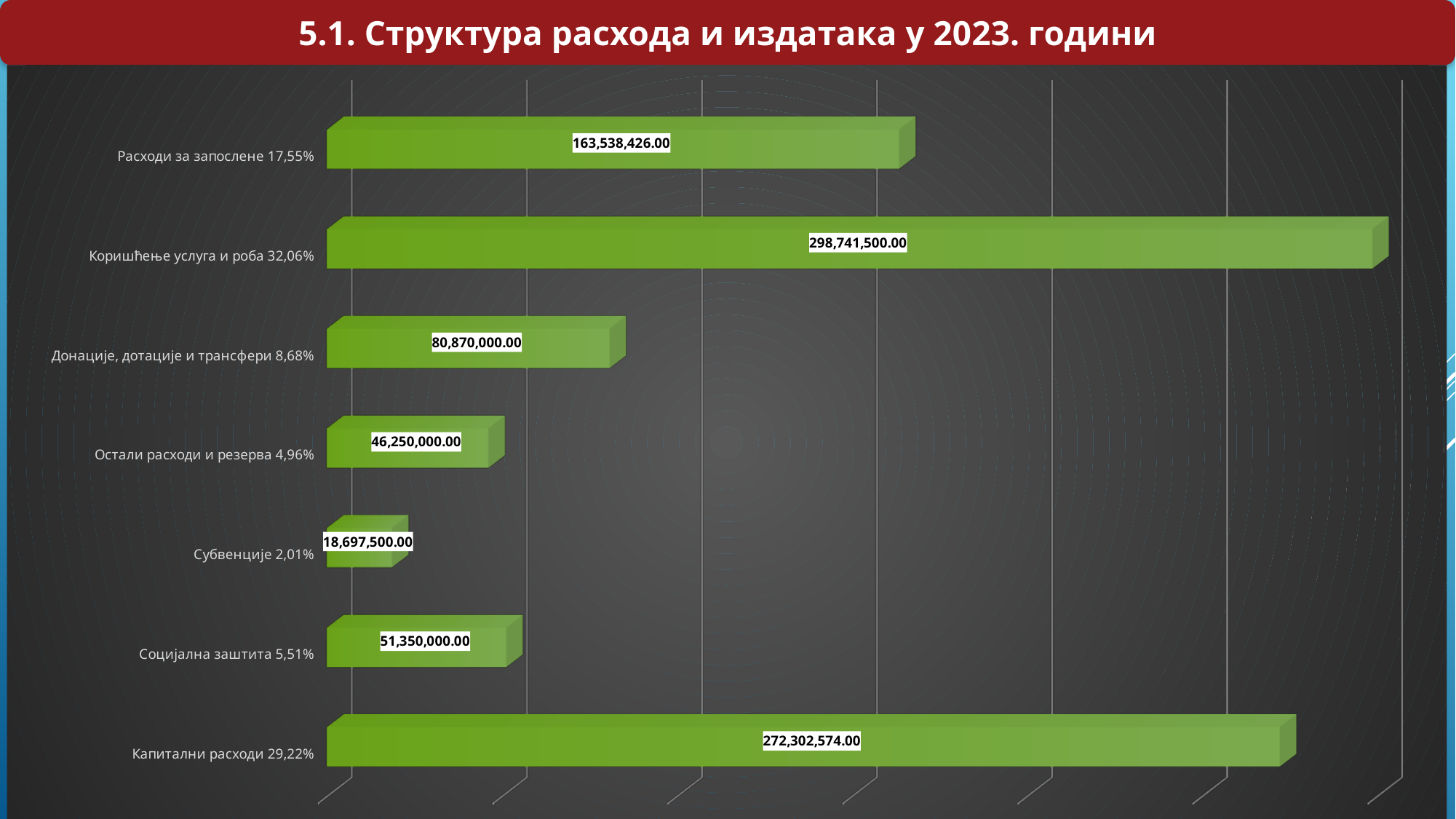
What is the value for Субвенције? 18,697,500.00 How many categories are shown in the chart? 7 What is the difference between the values for Коришћење услуга и роба and Капитални расходи? 26,438,926.00 What is the value for Коришћење услуга и роба? 298,741,500.00 What kind of chart is shown on the slide? Bar chart Which is larger, the value for Расходи за запослене or the value for Донације, дотације и трансфери? Расходи за запослене What is the difference between the values for Социјална заштита and Остали расходи и резерва? 5,100,000.00 Which category has the lowest value? Субвенције What is the value for Социјална заштита? 51,350,000.00 What is the value for Капитални расходи? 272,302,574.00 Which category has the highest value? Коришћење услуга и роба What percentage share is shown in the label for Капитални расходи? 29,22%